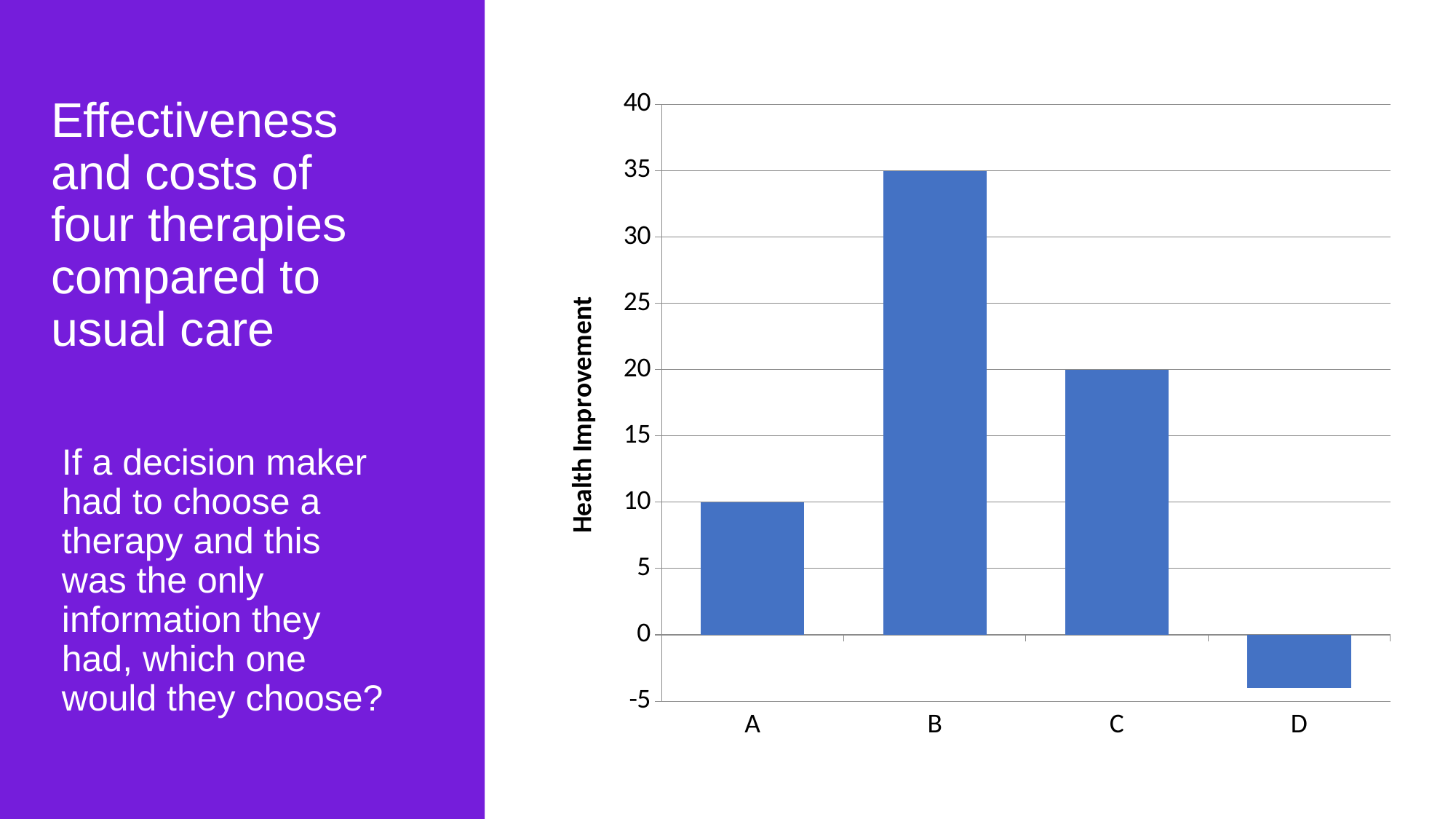
What kind of chart is shown on the slide? bar chart How many therapies are shown on the x axis of the chart? 4 What is the difference in Health Improvement between therapy B and therapy C? 15 What is the Health Improvement value for therapy A? 10 What is the label on the vertical axis of the chart? Health Improvement What is the Health Improvement value for therapy B? 35 Is the Health Improvement value for therapy D greater or less than 0? less Which has the larger Health Improvement, therapy A or therapy C? C Which therapy has the highest Health Improvement? B Which therapy has the lowest Health Improvement? D What is the difference in Health Improvement between therapy B and therapy A? 25 What is the Health Improvement value for therapy C? 20